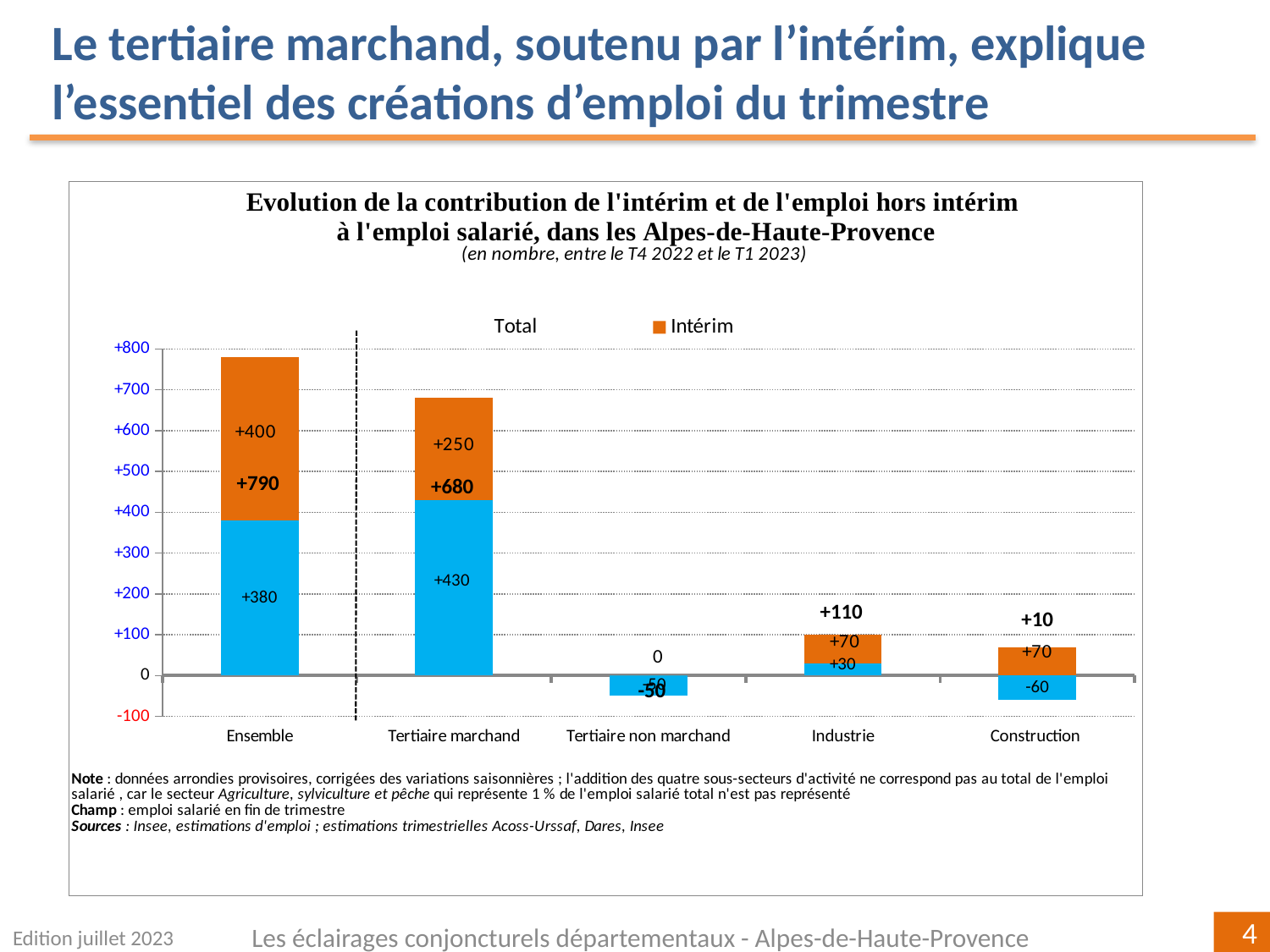
Which category has the highest total value? Ensemble What is the Intérim value for Tertiaire marchand? +250 Which has the larger total value, Tertiaire marchand or Industrie? Tertiaire marchand Which category has the lowest total value? Tertiaire non marchand What is the difference between the Intérim value for Ensemble and the Intérim value for Tertiaire marchand? 150 What is the Intérim value for Ensemble? +400 How many categories are shown on the x axis? 5 What is the Intérim value for Tertiaire non marchand? 0 What is the total value shown for Tertiaire non marchand? -50 What is the total value shown for Industrie? +110 What is the total value shown for Construction? +10 What kind of chart is this? Stacked bar chart